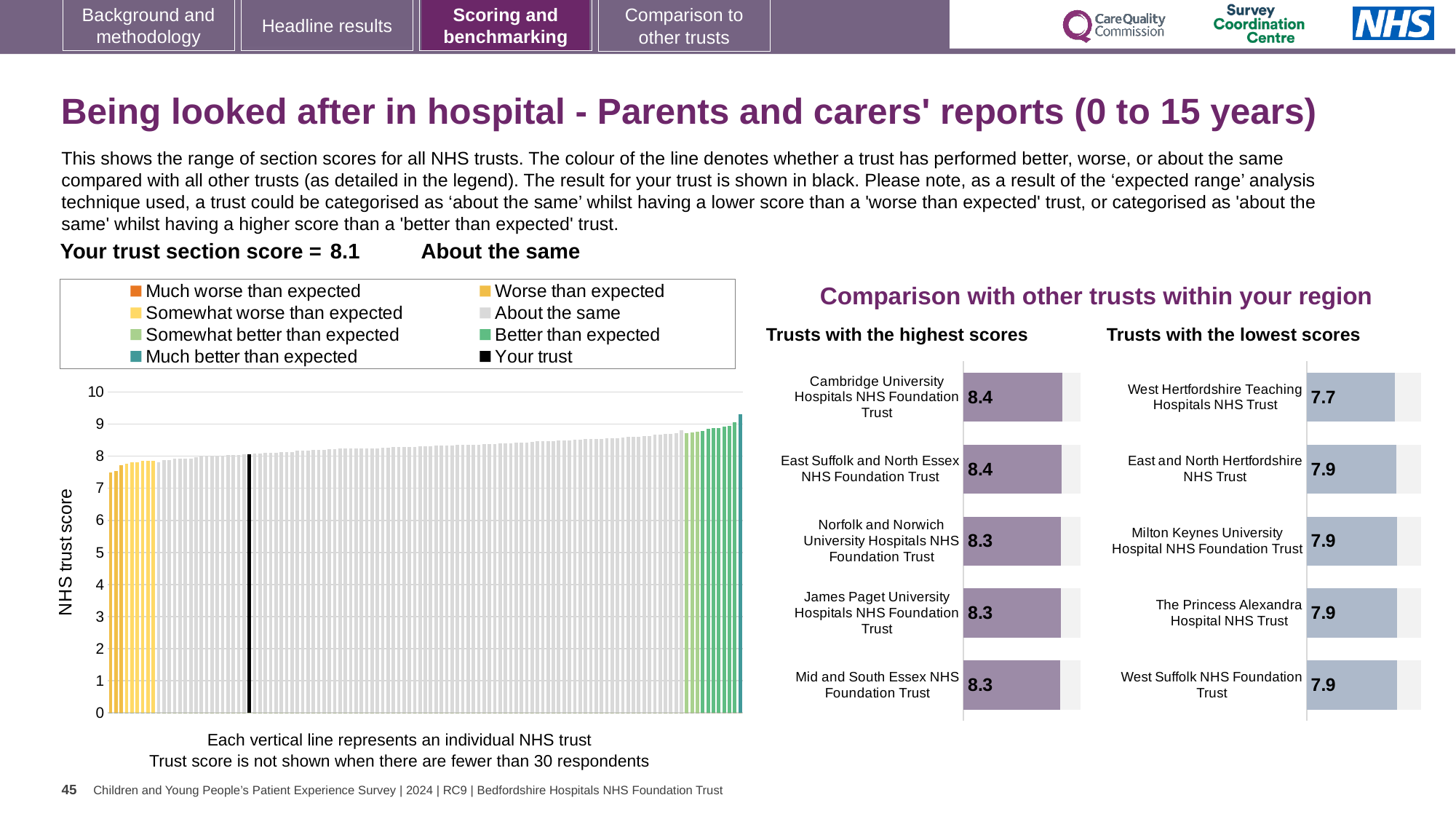
What kind of chart is the main chart on the left showing the range of section scores? bar chart In the main chart on the left, is the value for your trust (the black bar) greater or less than 5? greater In the 'Trusts with the highest scores' chart, what is the difference between the scores of East Suffolk and North Essex NHS Foundation Trust and Mid and South Essex NHS Foundation Trust? 0.1 In the 'Trusts with the highest scores' chart, what is the score for Cambridge University Hospitals NHS Foundation Trust? 8.4 In the 'Trusts with the lowest scores' chart, which has the larger score: West Hertfordshire Teaching Hospitals NHS Trust or West Suffolk NHS Foundation Trust? West Suffolk NHS Foundation Trust In the main chart on the left, what is the section score for your trust (the black bar)? 8.1 In the main chart on the left, what is the label on the vertical axis? NHS trust score How many entries does the legend above the main chart on the left list? 8 In the 'Trusts with the highest scores' chart, how many trusts are shown? 5 In the main chart on the left, do the bar values rise or fall from left to right? rise In the 'Trusts with the lowest scores' chart, which trust has the lowest score? West Hertfordshire Teaching Hospitals NHS Trust In the 'Trusts with the lowest scores' chart, what is the score for Milton Keynes University Hospital NHS Foundation Trust? 7.9